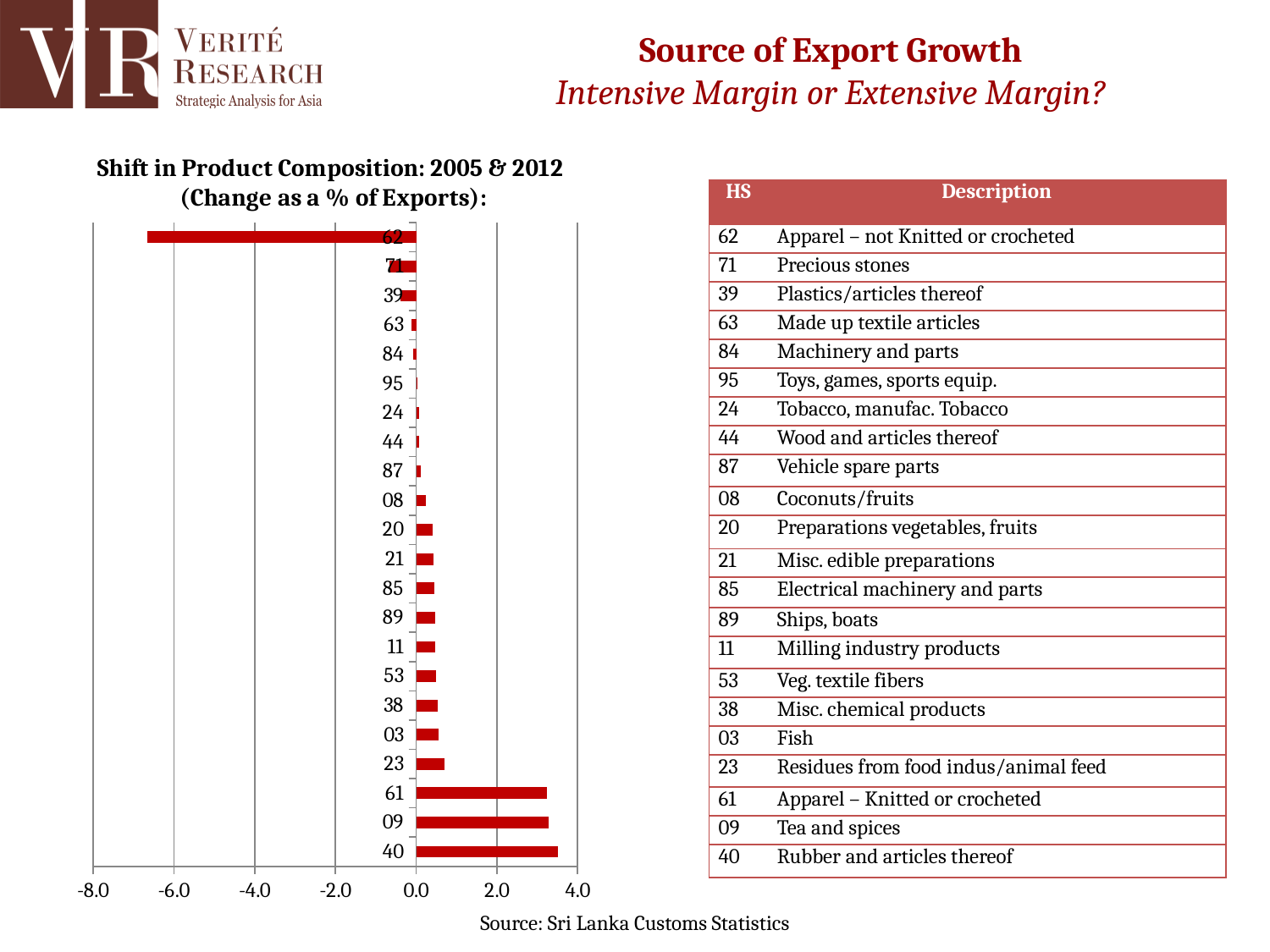
What kind of chart is shown on the slide? bar chart Which HS code has the highest change as a % of exports? 40 How many HS code categories are plotted in the chart? 22 Is the value for HS code 61 greater or less than 2.0? greater Is the value for HS code 62 greater or less than -6.0? less Which has the larger value, HS code 62 or HS code 40? 40 Is the value for HS code 40 greater or less than 2.0? greater What source is cited for the chart data? Sri Lanka Customs Statistics Which HS code has the lowest (most negative) change as a % of exports? 62 Which has the larger value, HS code 23 or HS code 61? 61 What is the title of the chart? Shift in Product Composition: 2005 & 2012 (Change as a % of Exports)